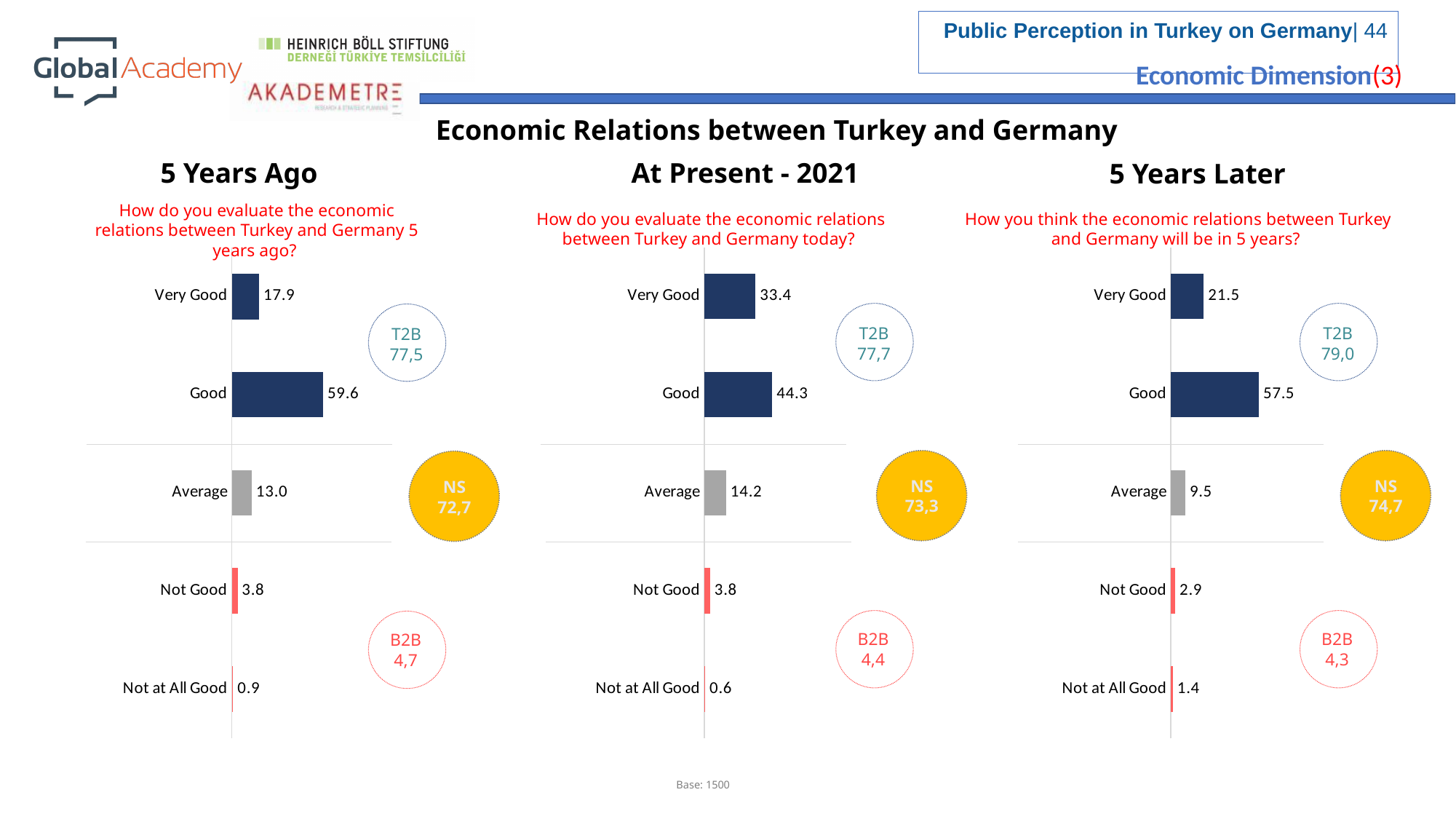
How many categories are shown in the '5 Years Ago' chart? 5 What kind of chart is the 'At Present - 2021' chart? Bar chart In the 'At Present - 2021' chart, what is the difference between the values for Good and Very Good? 10.9 In the '5 Years Later' chart, which category has the highest value? Good In the '5 Years Ago' chart, what is the total of the Very Good and Good values? 77.5 In the '5 Years Ago' chart, what is the value for Good? 59.6 In the '5 Years Later' chart, what is the value for Not at All Good? 1.4 Which is larger in the '5 Years Later' chart: the value for Average or the value for Not Good? Average In the '5 Years Ago' chart, what is the difference between the values for Good and Very Good? 41.7 In the 'At Present - 2021' chart, what is the value for Very Good? 33.4 In the 'At Present - 2021' chart, which category has the lowest value? Not at All Good What is the T2B value shown next to the '5 Years Later' chart? 79,0